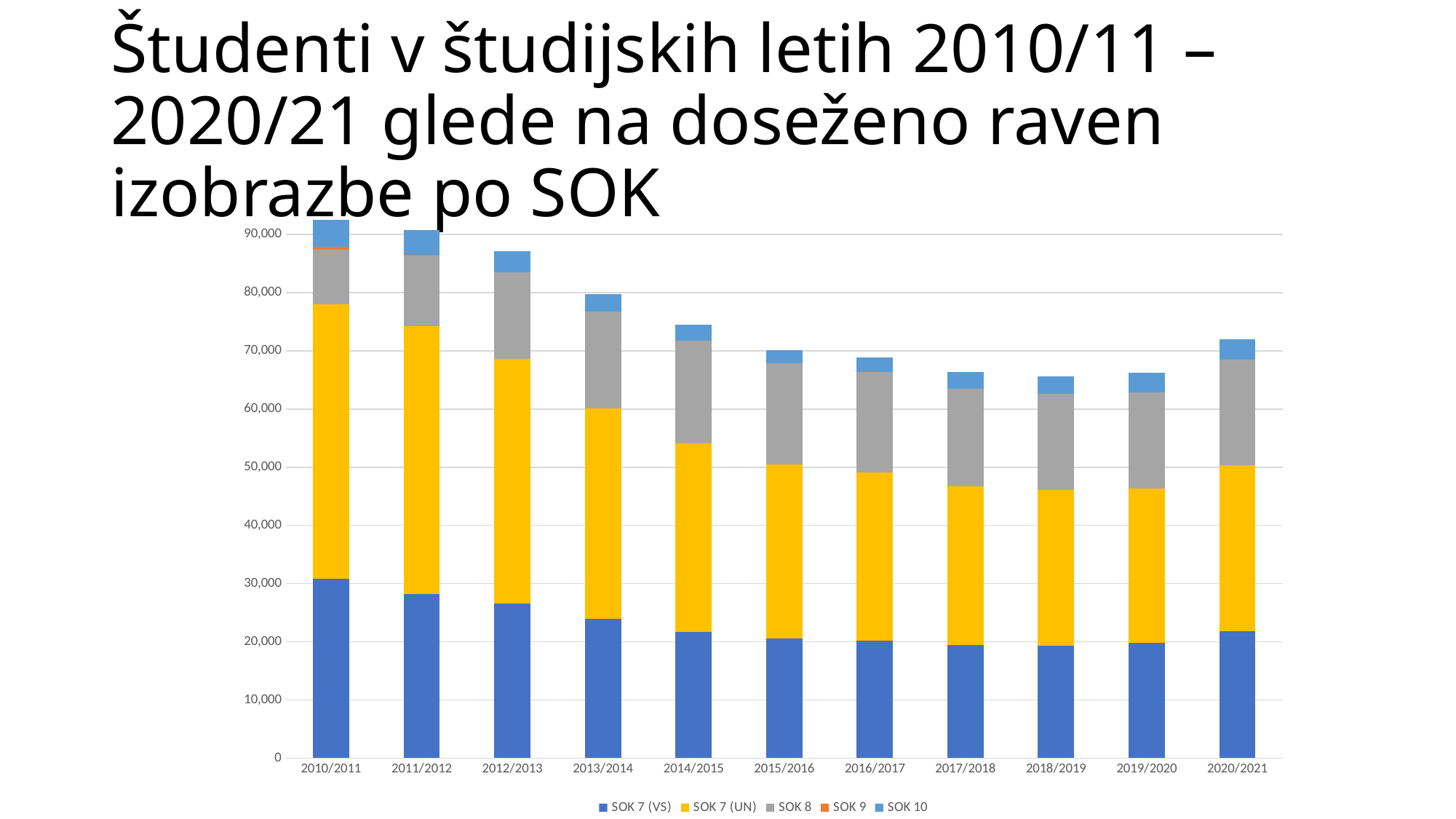
Is the total stacked bar for 2020/2021 greater or less than 70,000? greater Which has the larger total stacked bar, 2010/2011 or 2020/2021? 2010/2011 Which academic year has the tallest stacked bar (highest total number of students)? 2010/2011 What kind of chart is shown on the slide? Stacked bar chart Is the total stacked bar for 2014/2015 greater or less than 80,000? less How many series does the legend list? 5 How many academic years (categories) are shown on the x axis? 11 Is the total stacked bar for 2010/2011 greater or less than 90,000? greater Do the total stacked bars generally rise or fall from 2010/2011 to 2019/2020? fall Which has the larger total stacked bar, 2012/2013 or 2013/2014? 2012/2013 Which colour represents the SOK 7 (UN) series in the legend? Yellow